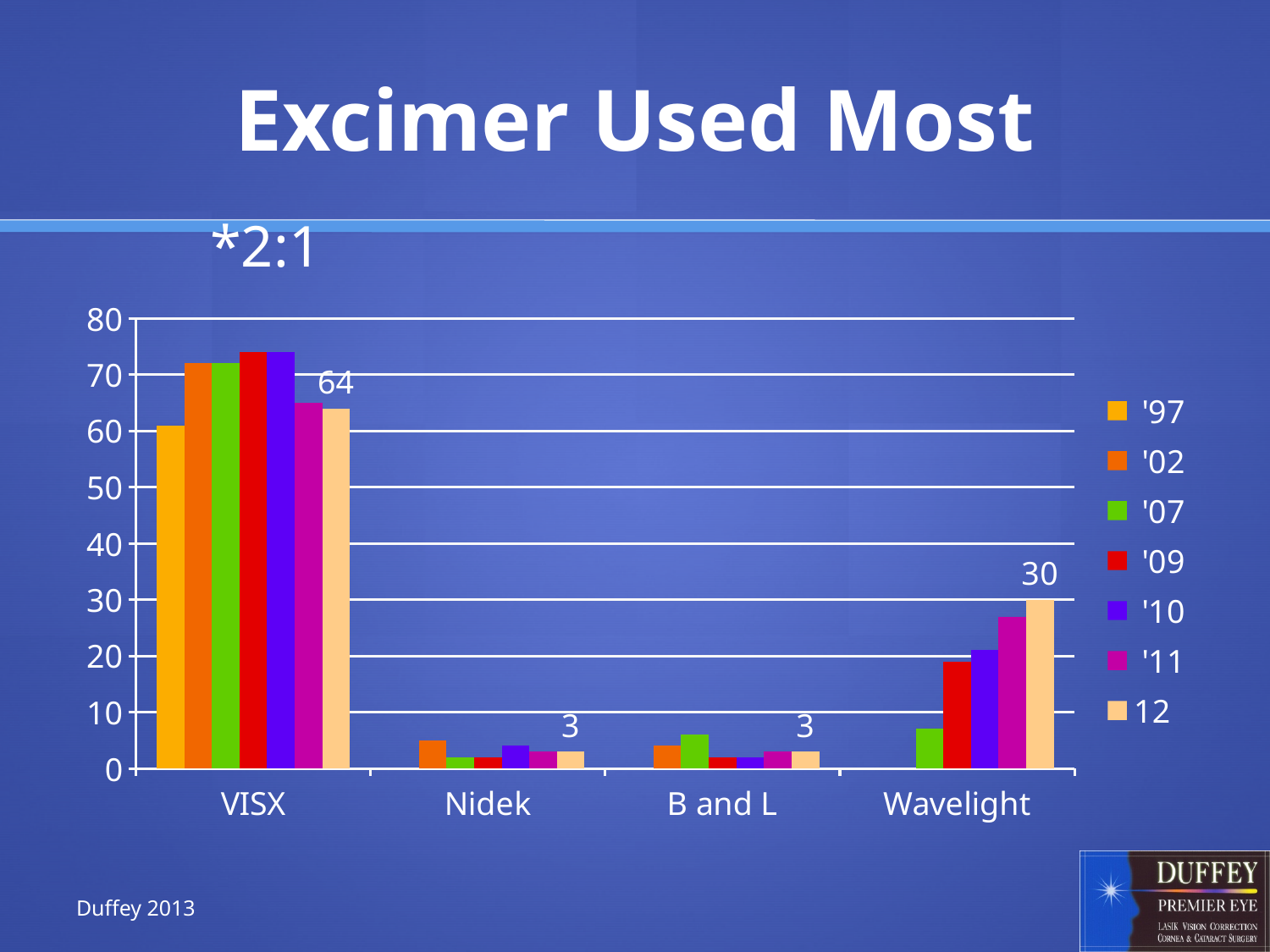
What is the value for VISX in the 12 series? 64 Is the value for VISX in the '97 series greater or less than 50? greater Which category has the highest value in the 12 series? VISX What kind of chart is shown on the slide? bar chart In the 12 series, which is larger: VISX or Wavelight? VISX What is the value for Wavelight in the 12 series? 30 How many series does the legend list? 7 What is the difference between the 12 series values for VISX and Wavelight? 34 What is the value for Nidek in the 12 series? 3 What is the title of the slide containing the chart? Excimer Used Most How many categories are shown on the x axis? 4 Is the value for Wavelight in the '11 series greater or less than 20? greater